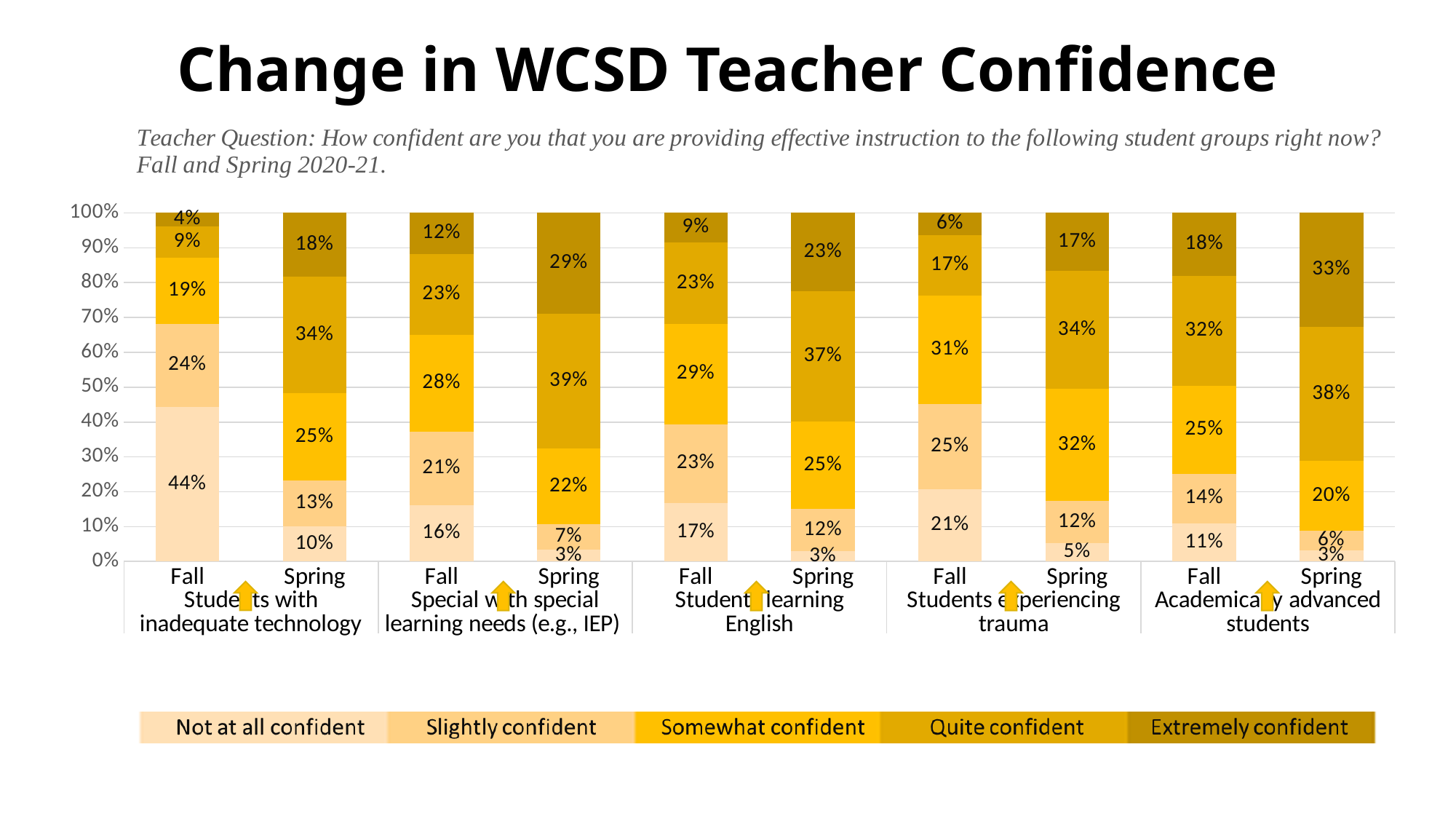
What is the title of the chart? Change in WCSD Teacher Confidence Is the "Quite confident" share for students learning English larger in Fall or in Spring? Spring What percentage of teachers were "Quite confident" about students with special learning needs in Spring? 39% What percentage of teachers were "Somewhat confident" about students experiencing trauma in Fall? 31% What type of chart is shown on the slide? Stacked bar chart What is the difference between the Fall and Spring "Not at all confident" shares for students with inadequate technology? 34% What percentage of teachers were "Extremely confident" about academically advanced students in Spring? 33% Which student group has the lowest "Extremely confident" share in Fall? Students with inadequate technology How many series does the legend list? 5 What percentage of teachers were "Not at all confident" about students with inadequate technology in Fall? 44% How many student groups are shown on the x axis? 5 Which student group has the highest "Not at all confident" share in Fall? Students with inadequate technology